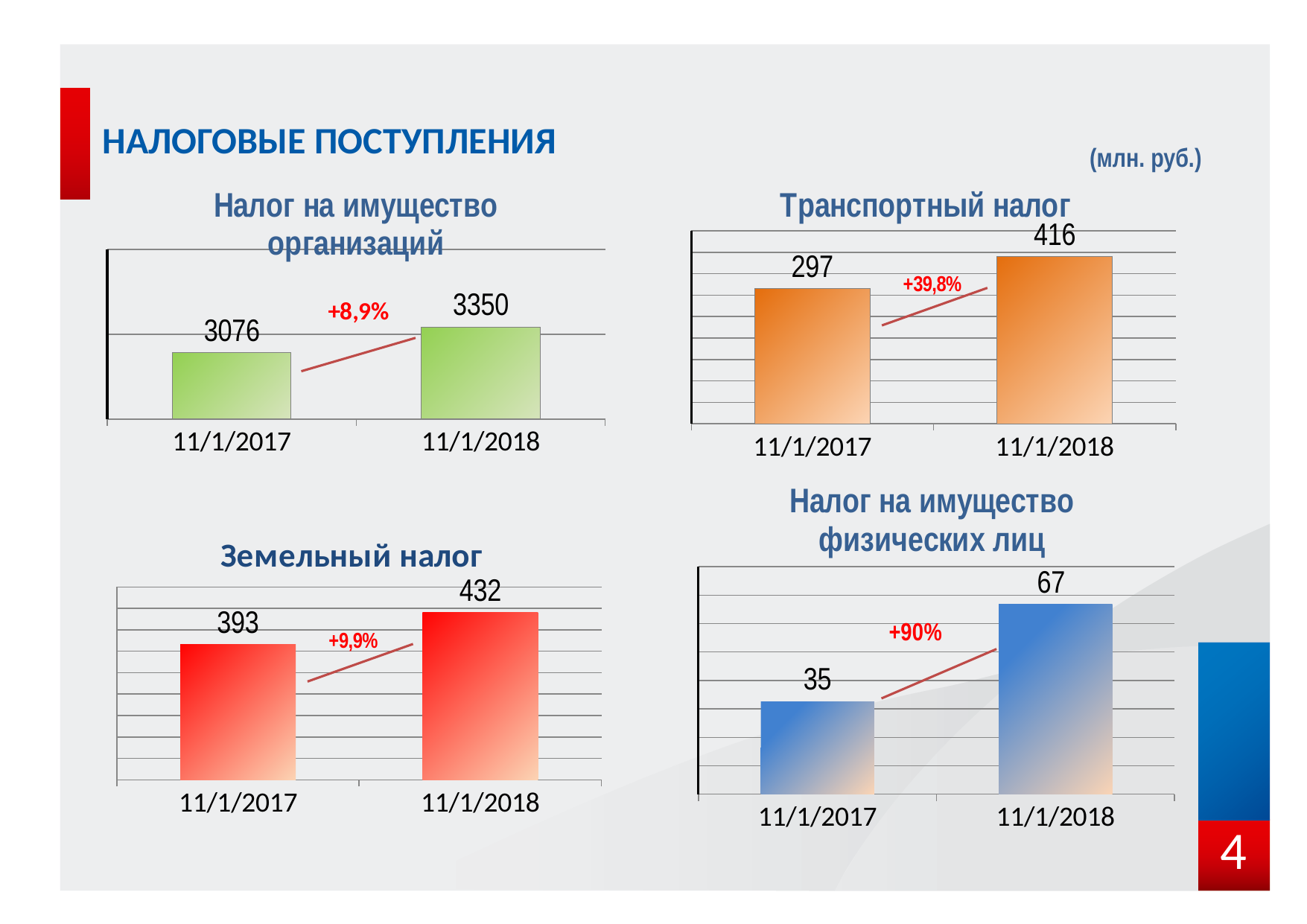
In the 'Налог на имущество физических лиц' chart, what is the value for 11/1/2017? 35 In the 'Налог на имущество организаций' chart, what is the value for 11/1/2018? 3350 In the 'Земельный налог' chart, what is the value for 11/1/2018? 432 In the 'Транспортный налог' chart, what is the difference between the 11/1/2018 and 11/1/2017 values? 119 In the 'Налог на имущество физических лиц' chart, which date has the higher value? 11/1/2018 How many bars are in the 'Земельный налог' chart? 2 In the 'Земельный налог' chart, what is the difference between the 11/1/2018 and 11/1/2017 values? 39 In the 'Налог на имущество организаций' chart, what is the value for 11/1/2017? 3076 In the 'Налог на имущество физических лиц' chart, what percentage change is shown between the two bars? +90% In the 'Транспортный налог' chart, do the values rise or fall from 11/1/2017 to 11/1/2018? rise In the 'Транспортный налог' chart, what is the value for 11/1/2017? 297 What type of chart is the 'Транспортный налог' chart? bar chart